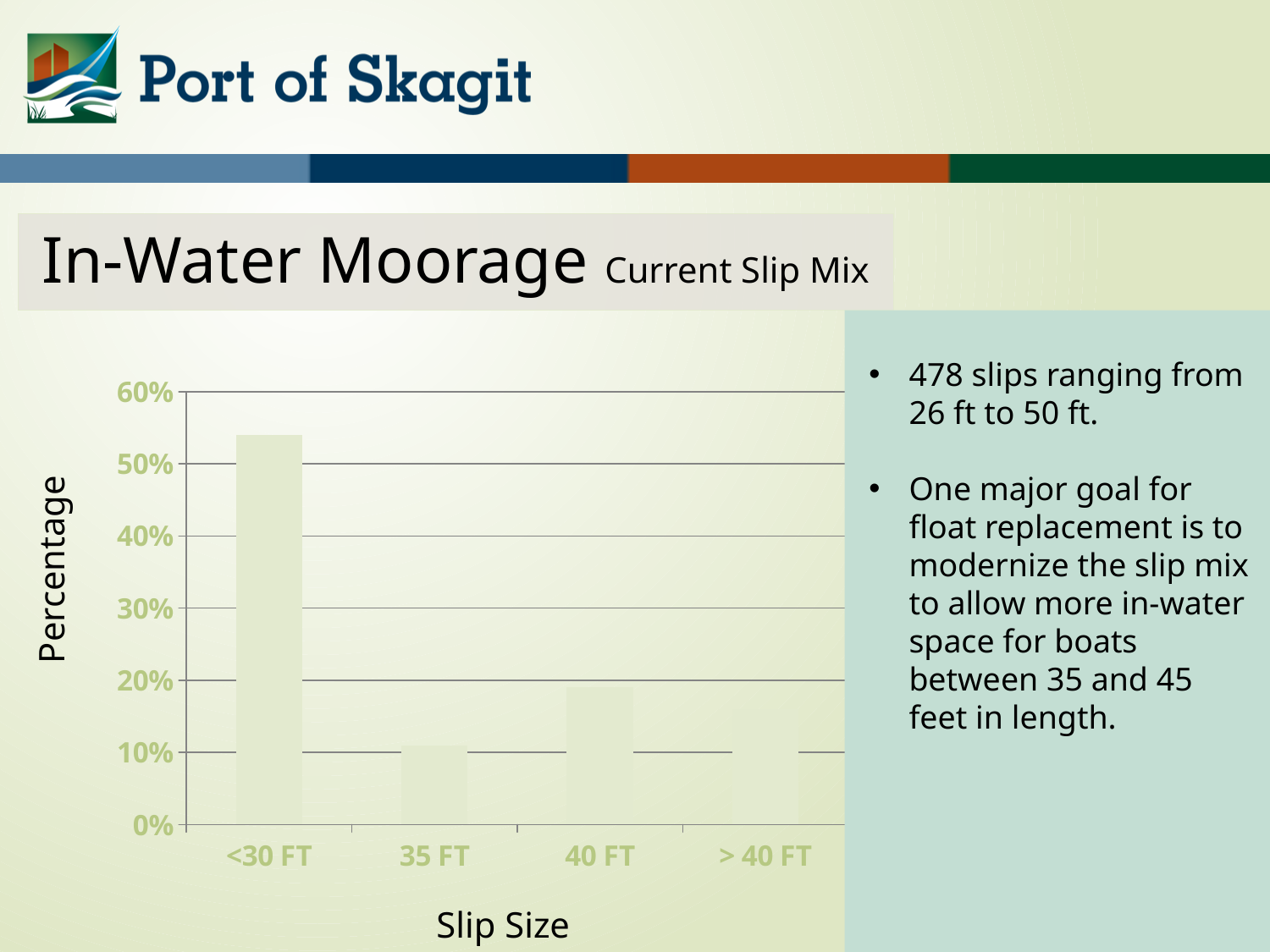
Is the value for > 40 FT greater or less than 20%? less What kind of chart is shown on the slide? bar chart Which has a larger percentage, 40 FT or 35 FT? 40 FT What is the label of the vertical axis of the chart? Percentage Which has a larger percentage, <30 FT or > 40 FT? <30 FT Is the value for 40 FT greater or less than 10%? greater How many slip size categories are shown on the x axis of the chart? 4 Is the value for <30 FT greater or less than 50%? greater Which slip size has the highest percentage in the chart? <30 FT What is the label of the horizontal axis of the chart? Slip Size Which slip size has the lowest percentage in the chart? 35 FT